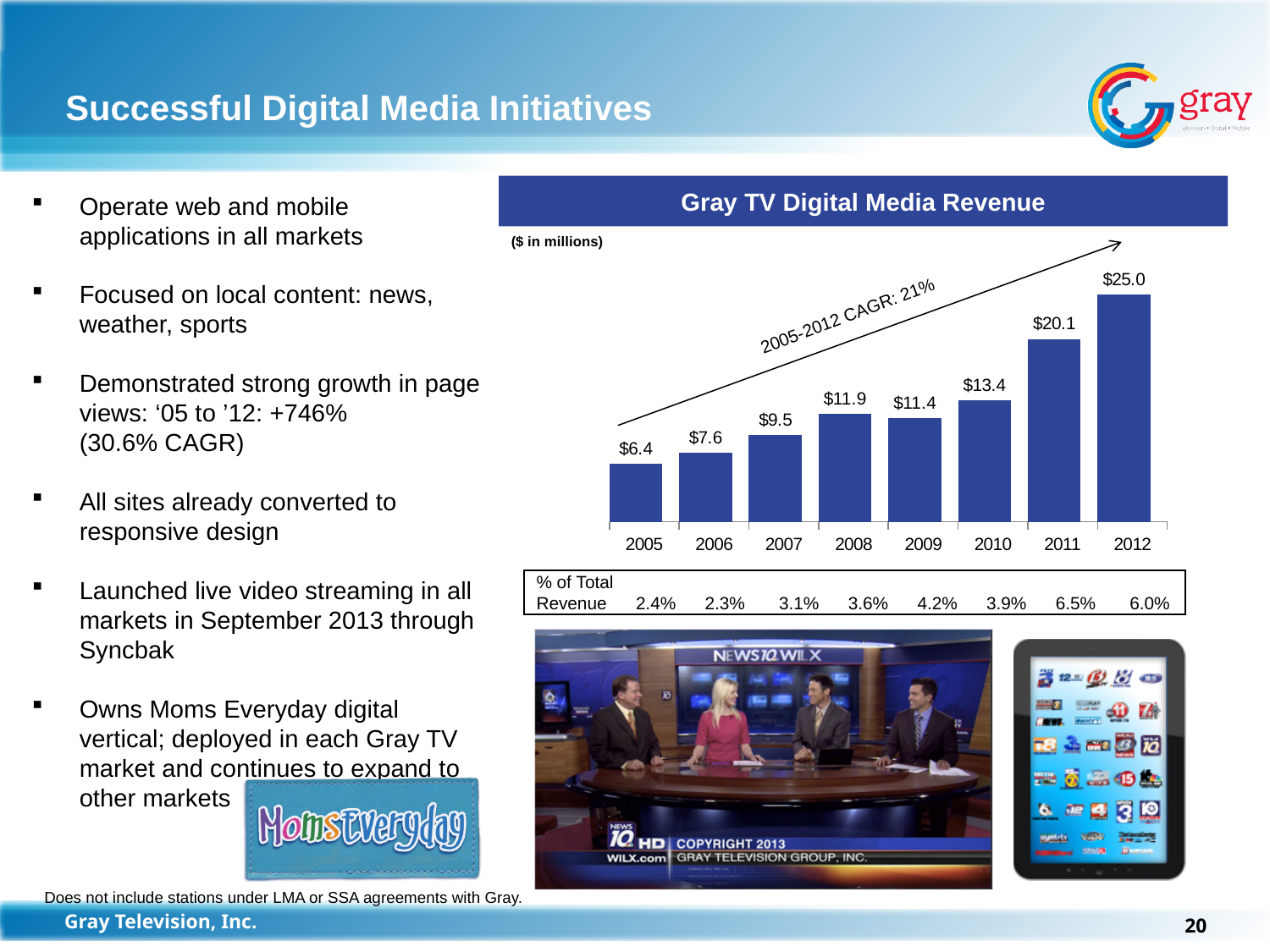
What unit is the Gray TV Digital Media Revenue chart expressed in? $ in millions Which year has higher Gray TV Digital Media Revenue, 2008 or 2009? 2008 Which year has the highest Gray TV Digital Media Revenue? 2012 Which year has the lowest Gray TV Digital Media Revenue? 2005 What is the difference in Gray TV Digital Media Revenue between 2010 and 2009? $2.0 What is the Gray TV Digital Media Revenue for 2012? $25.0 What is the 2005-2012 CAGR shown on the Gray TV Digital Media Revenue chart? 21% How many years are shown in the Gray TV Digital Media Revenue chart? 8 What is the difference in Gray TV Digital Media Revenue between 2012 and 2011? $4.9 What is the Gray TV Digital Media Revenue for 2009? $11.4 What is the Gray TV Digital Media Revenue for 2005? $6.4 What type of chart is the Gray TV Digital Media Revenue chart? Bar chart